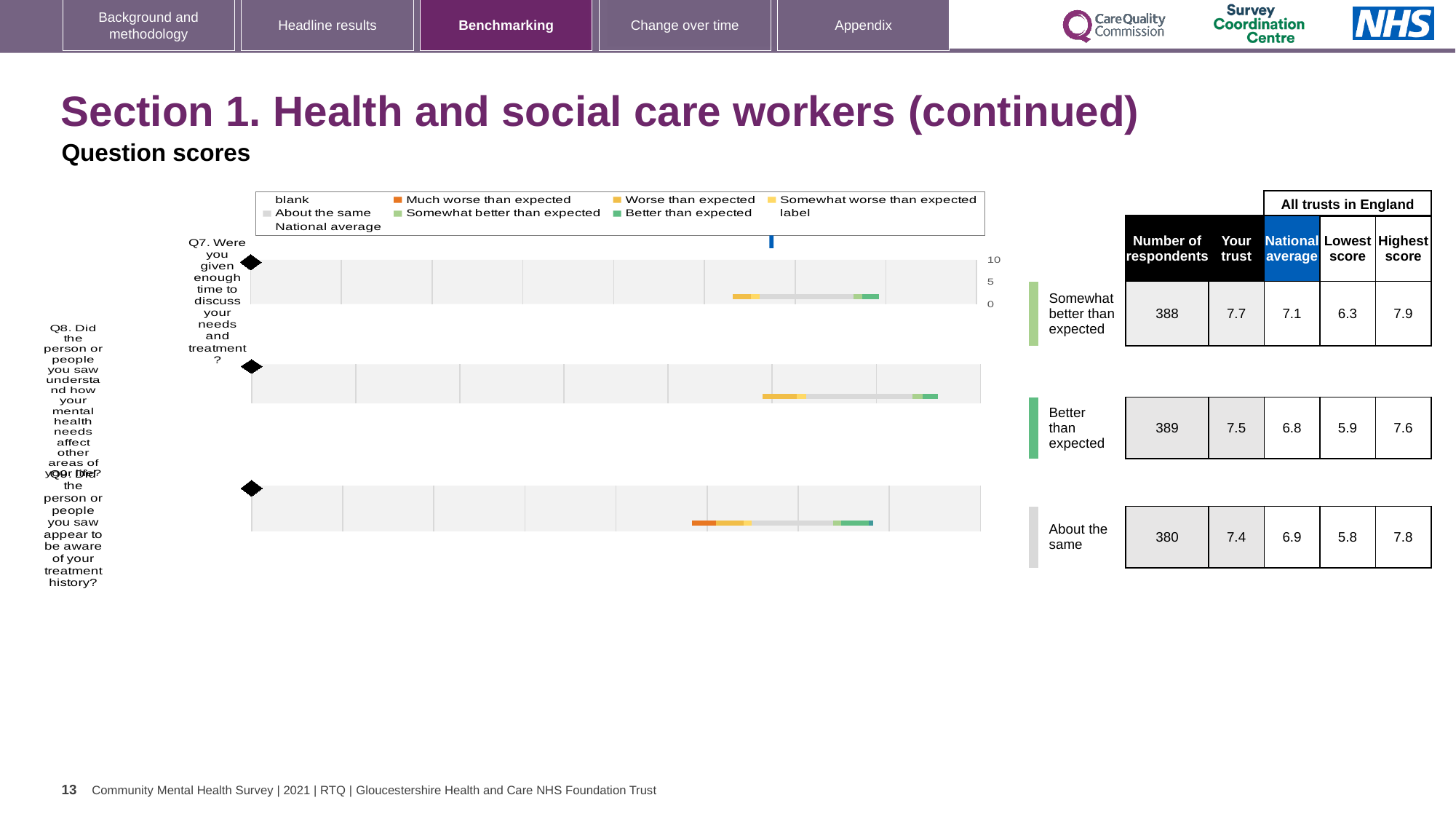
What kind of chart is used to show the Q7, Q8 and Q9 question scores? bar chart In the table next to the Q8 chart, what is the highest score among all trusts in England? 7.6 In the table next to the Q9 chart, what is the lowest score among all trusts in England? 5.8 For Q9, which is larger: the 'Your trust' score or the national average? Your trust What benchmark category is shown beside the Q8 chart? Better than expected Which of Q7, Q8 and Q9 has the fewest respondents? Q9 Which of Q7, Q8 and Q9 has the highest 'Your trust' score? Q7 In the table next to the Q8 chart, how many respondents are listed? 389 In the table next to the Q7 chart, what is the 'Your trust' score? 7.7 In the table next to the Q7 chart, what is the national average score? 7.1 For Q7, what is the difference between the 'Your trust' score and the national average? 0.6 How many question charts (Q7, Q8, Q9) are shown on the slide? 3